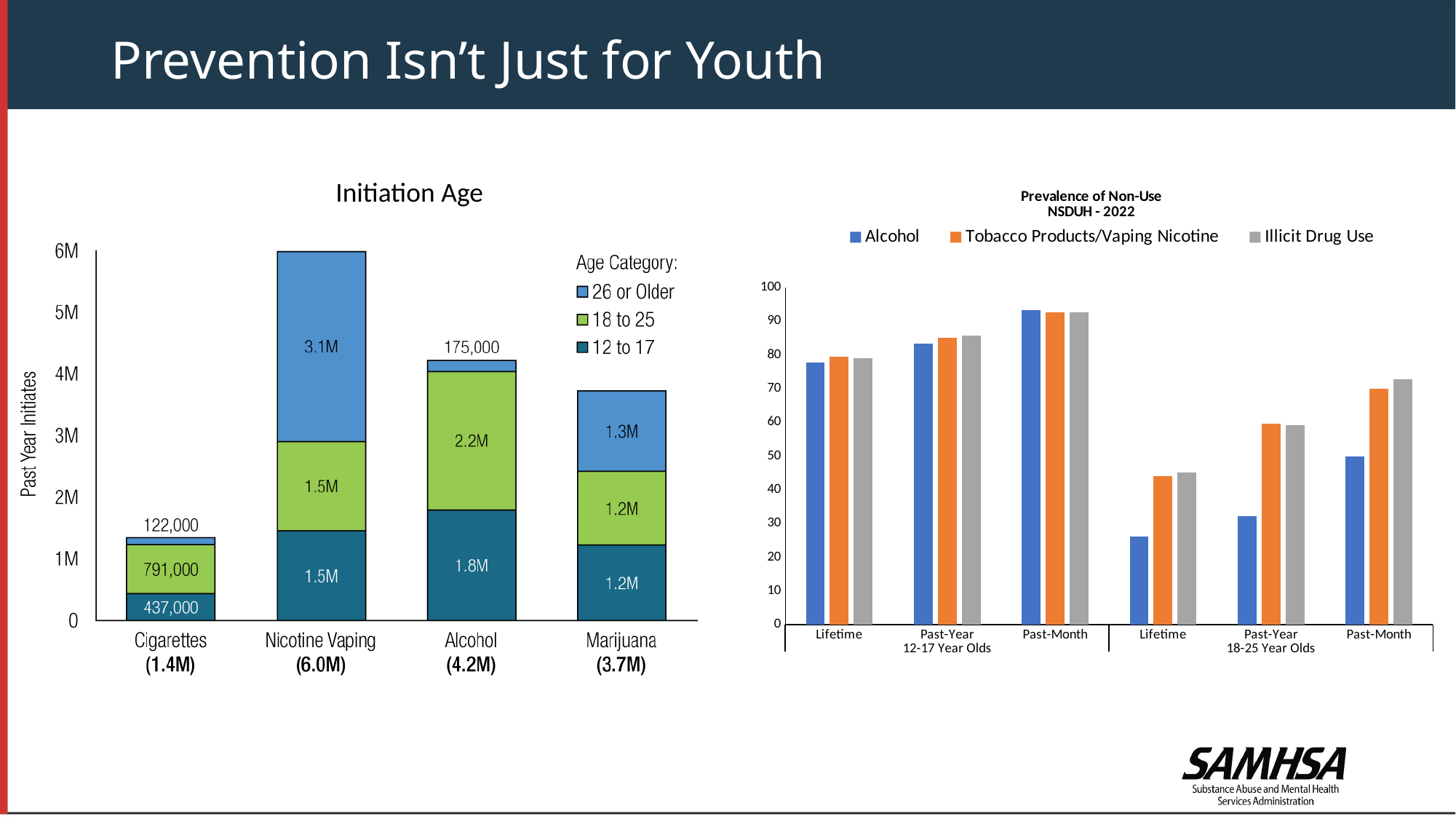
What kind of chart is the Prevalence of Non-Use chart? Bar chart On the Initiation Age chart, what is the value for the 26 or Older segment of the Nicotine Vaping bar? 3.1M On the Initiation Age chart, which substance has the highest total number of past year initiates? Nicotine Vaping On the Prevalence of Non-Use chart, is the Alcohol value for Past-Month among 12-17 Year Olds greater or less than 90? greater On the Initiation Age chart, what is the value for the 18 to 25 segment of the Alcohol bar? 2.2M On the Prevalence of Non-Use chart, is the Alcohol value for Lifetime among 18-25 Year Olds greater or less than 30? less On the Initiation Age chart, how many age categories does the legend list? 3 On the Prevalence of Non-Use chart, which is larger for Lifetime among 18-25 Year Olds: Alcohol or Tobacco Products/Vaping Nicotine? Tobacco Products/Vaping Nicotine On the Initiation Age chart, which substance has the lowest total number of past year initiates? Cigarettes On the Initiation Age chart, what is the total number of past year initiates for Marijuana? 3.7M On the Initiation Age chart, which is larger: the 26 or Older segment for Cigarettes or the 26 or Older segment for Alcohol? Alcohol On the Initiation Age chart, how many past year initiates aged 12 to 17 are shown for Cigarettes? 437,000